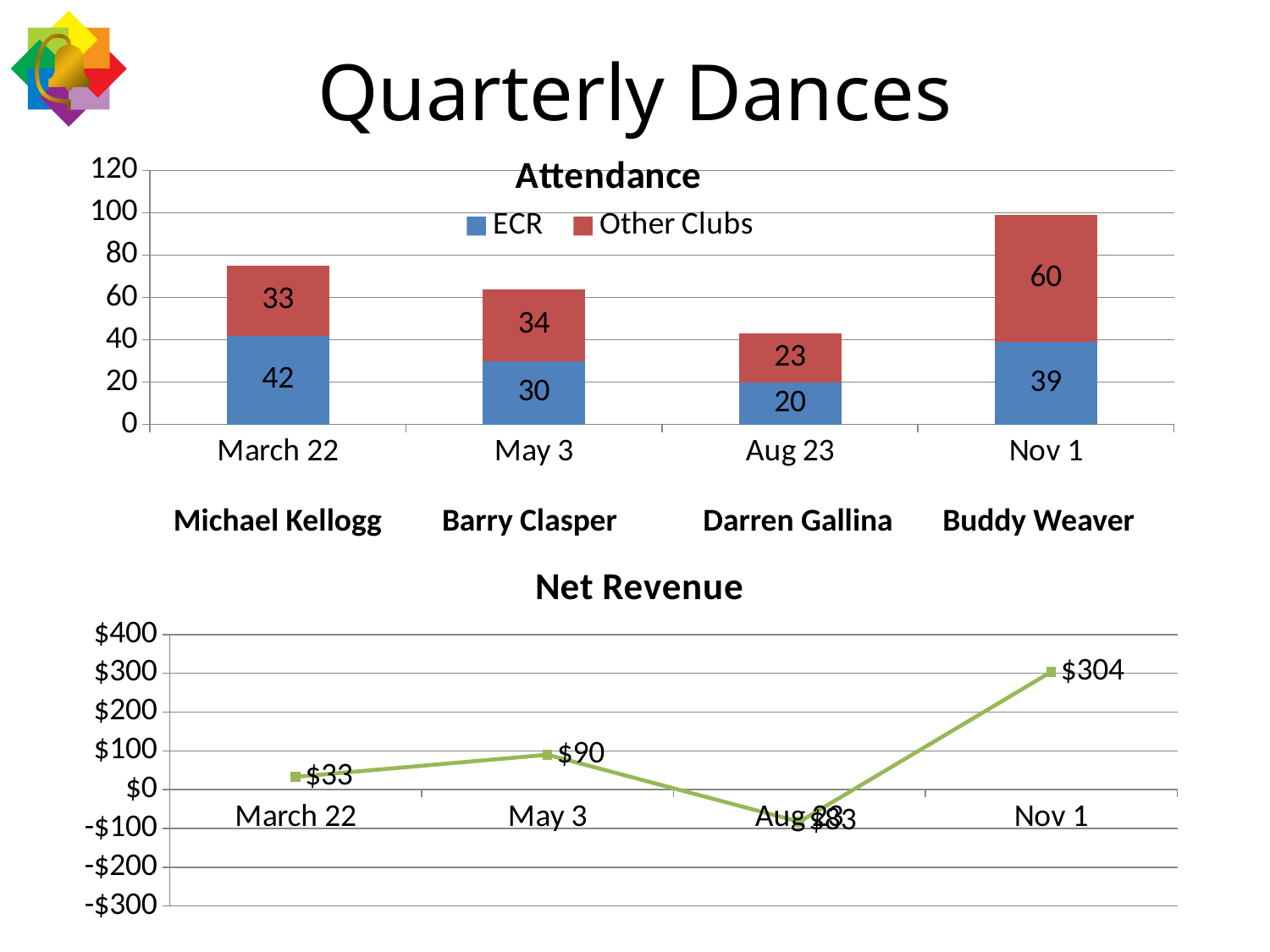
In the Net Revenue chart, which date has the highest net revenue? Nov 1 In the Attendance chart, what is the total attendance for May 3? 64 In the Attendance chart, which date has the highest Other Clubs attendance? Nov 1 In the Net Revenue chart, is the value for Aug 23 greater or less than $0? less In the Attendance chart, how many series does the legend list? 2 What kind of chart is the Attendance chart? Stacked bar chart In the Attendance chart, what is the ECR value for Aug 23? 20 In the Net Revenue chart, what is the value for Nov 1? $304 In the Attendance chart, what is the ECR value for March 22? 42 In the Attendance chart, what is the difference between the ECR values for March 22 and May 3? 12 In the Attendance chart, which date has the lowest ECR attendance? Aug 23 In the Attendance chart, what is the Other Clubs value for Nov 1? 60